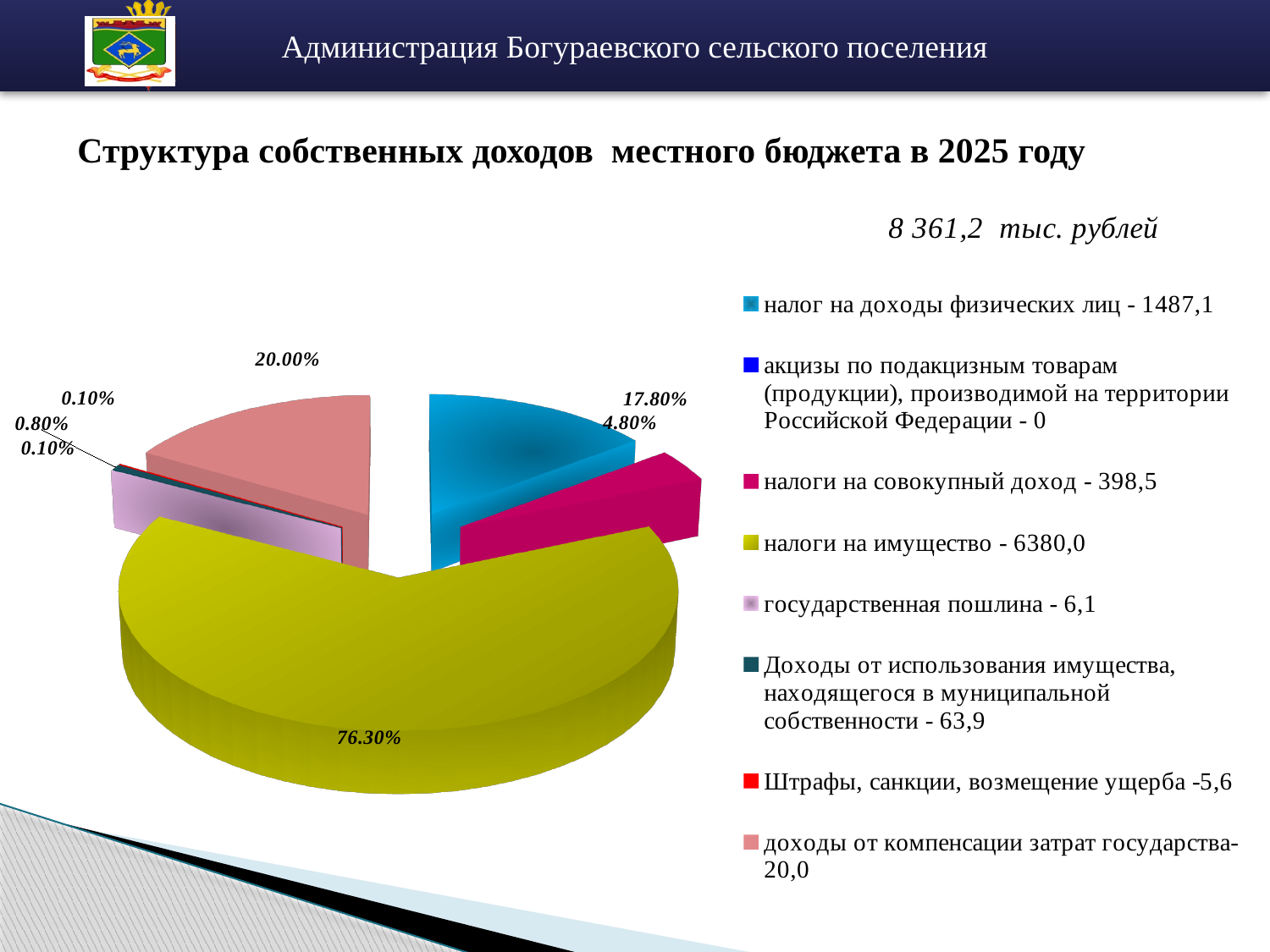
Which slice is larger: налог на доходы физических лиц or налоги на совокупный доход? налог на доходы физических лиц What kind of chart is shown on the slide? pie chart What share of the pie is labelled for налоги на совокупный доход? 4.80% What is the difference in percentage points between the slice for налоги на имущество and the slice for налог на доходы физических лиц? 58.50% What total amount is shown above the legend of the chart? 8 361,2 тыс. рублей What share of the pie is labelled for налоги на имущество? 76.30% How many categories does the legend of the pie chart list? 8 What value does the legend give for налог на доходы физических лиц? 1487,1 What value does the legend give for акцизы по подакцизным товарам (продукции), производимой на территории Российской Федерации? 0 What share of the pie is labelled for налог на доходы физических лиц? 17.80% What value does the legend give for налоги на имущество? 6380,0 Which category has the largest slice of the pie? налоги на имущество